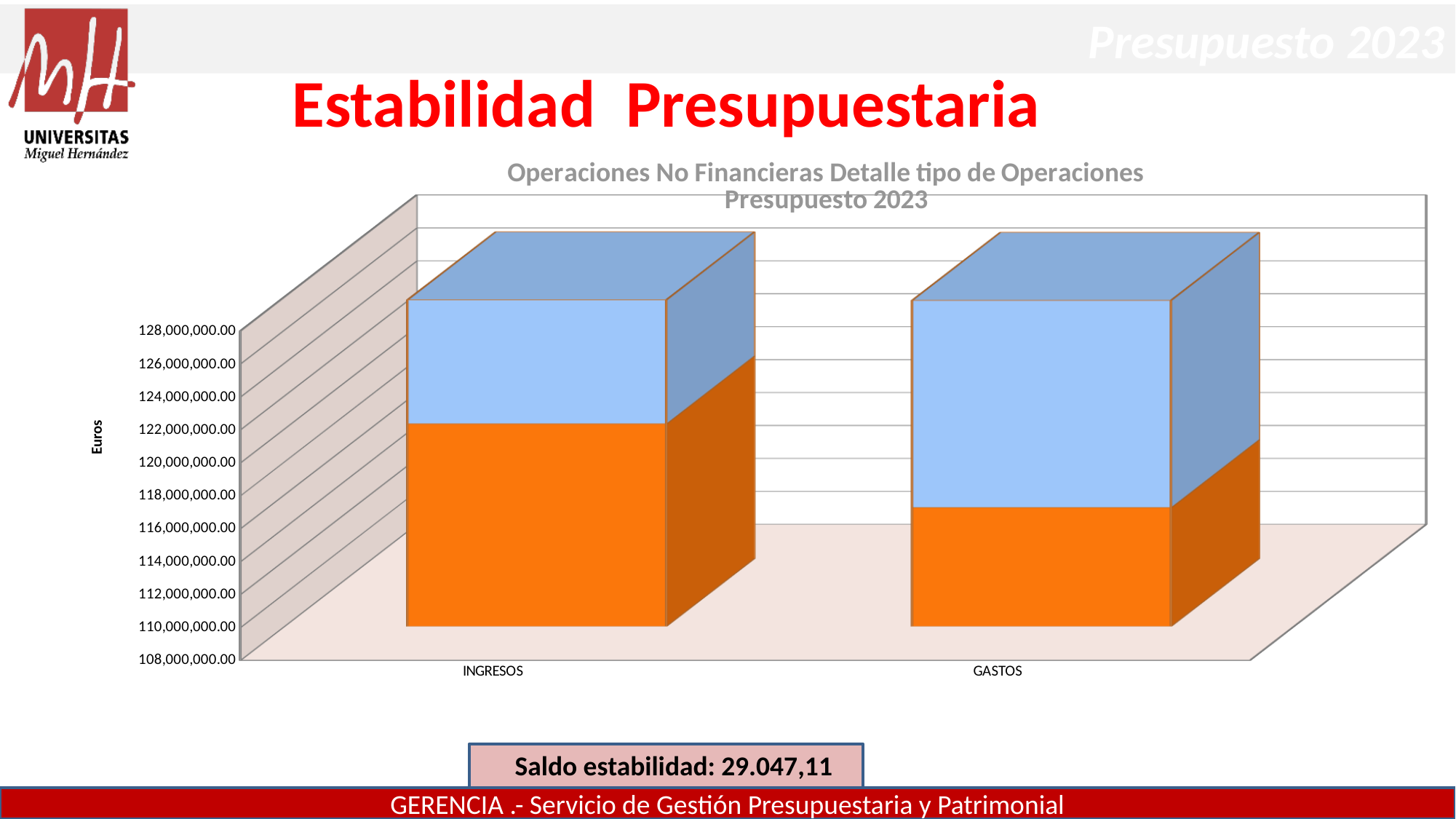
Which category has the larger orange segment, INGRESOS or GASTOS? INGRESOS What is the lowest value shown on the vertical axis of the chart? 108,000,000.00 What type of chart is shown on the slide? bar chart Is the top of the blue segment for GASTOS greater or less than 124,000,000.00? greater What are the two categories shown on the x axis of the chart? INGRESOS and GASTOS Is the top of the orange segment for INGRESOS greater or less than 118,000,000.00? greater How many categories are shown on the x axis of the chart? 2 Which category has the larger blue segment, INGRESOS or GASTOS? GASTOS What is the label of the vertical axis of the chart? Euros What is the highest value shown on the vertical axis of the chart? 128,000,000.00 Is the top of the orange segment for GASTOS greater or less than 120,000,000.00? less What is the title of the chart? Operaciones No Financieras Detalle tipo de Operaciones Presupuesto 2023